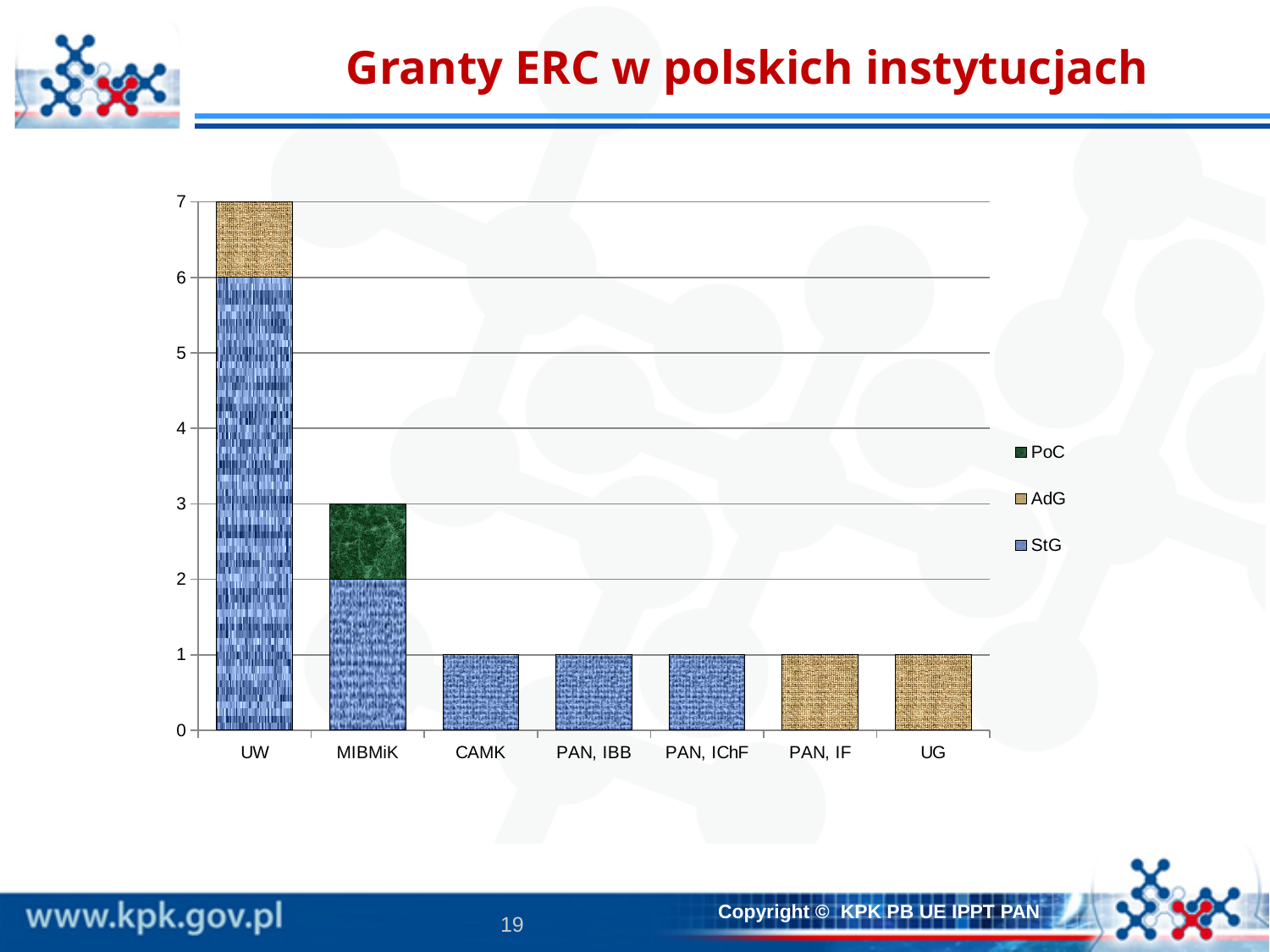
How many institutions (categories) are shown on the x axis? 7 What is the StG value for MIBMiK? 2 What is the title of the slide containing the chart? Granty ERC w polskich instytucjach What is the difference between the total for UW and the total for MIBMiK? 4 What is the total height of the bar for MIBMiK? 3 How many series does the legend list? 3 What type of chart is shown on the slide? stacked bar chart Which institution has the tallest bar? UW Which institution is the only one with a PoC segment? MIBMiK Which is larger, the bar for MIBMiK or the bar for CAMK? MIBMiK What is the total height of the bar for UW? 7 What is the StG value for UW? 6